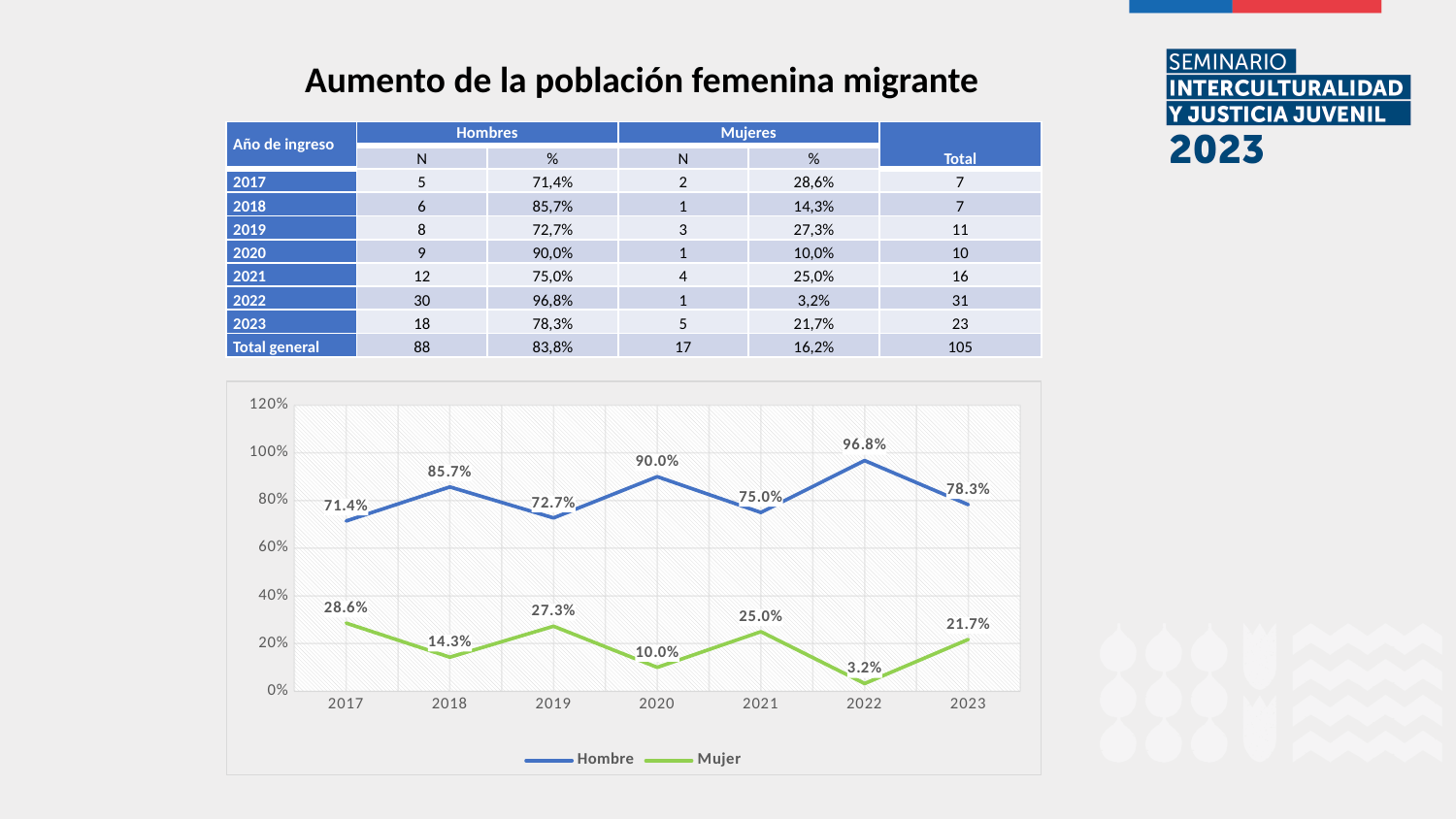
How many series does the chart legend list? 2 What kind of chart is shown on the slide? line chart In which year is the Hombre series at its lowest? 2017 What is the value for Hombre in 2022? 96.8% Which series is drawn with the green line? Mujer How many years are plotted on the x axis? 7 Does the Mujer series rise or fall from 2022 to 2023? rise In which year is the Mujer series at its lowest? 2022 In which year is the Mujer series at its highest? 2017 What is the difference between the Hombre and Mujer values in 2023? 56.6% Which is larger, the Mujer value in 2018 or the Mujer value in 2021? 2021 What is the value for Mujer in 2019? 27.3%